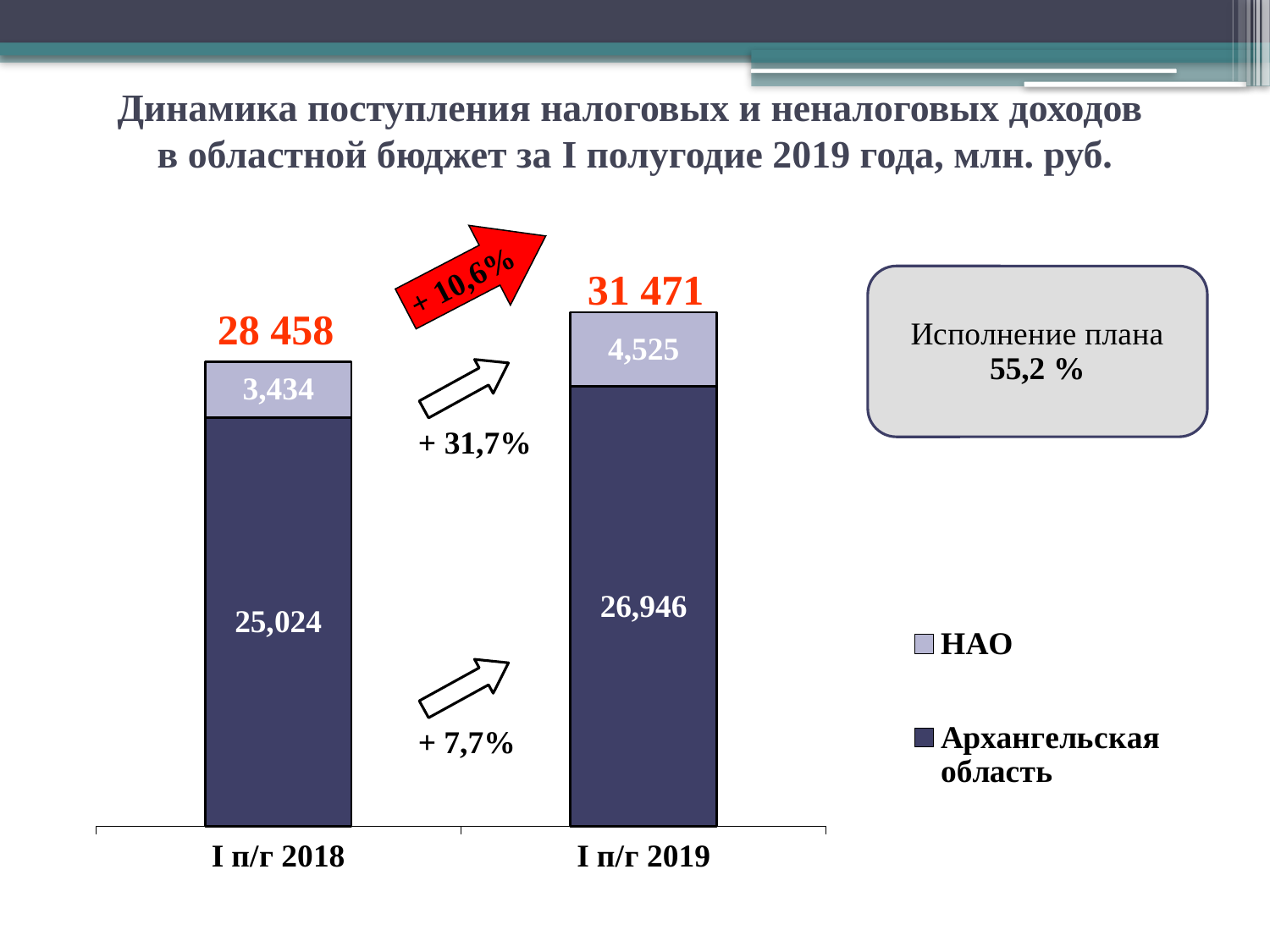
What is the value for Архангельская область in I п/г 2019? 26,946 How many series does the legend list? 2 What is the difference between the Архангельская область values for I п/г 2019 and I п/г 2018? 1,922 Is the value for НАО in I п/г 2019 larger or smaller than the value for НАО in I п/г 2018? larger What is the difference between the НАО values for I п/г 2019 and I п/г 2018? 1,091 What is the value for НАО in I п/г 2019? 4,525 What is the total of the stacked bar for I п/г 2018? 28 458 What is the value for НАО in I п/г 2018? 3,434 Which period has the lower value for НАО? I п/г 2018 What kind of chart is shown on the slide? stacked bar chart What is the total of the stacked bar for I п/г 2019? 31 471 Which period has the higher value for Архангельская область? I п/г 2019